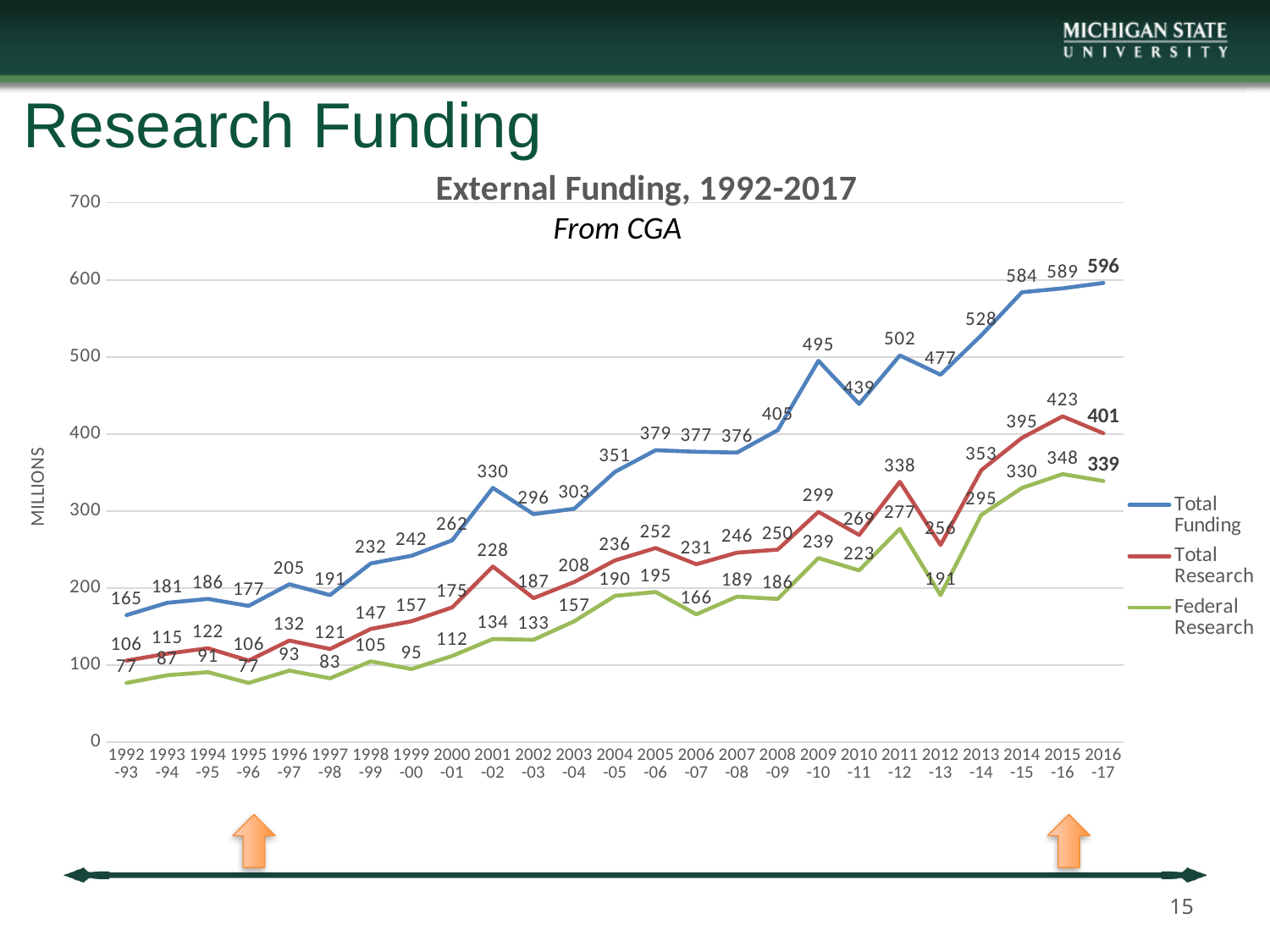
How many series does the legend list? 3 What is the difference between Total Funding and Total Research in 2009-10? 196 How many years are plotted on the x axis? 25 What is the Total Research value for 2011-12? 338 In which year is Total Research highest? 2015-16 What kind of chart is shown? line chart Is the Total Funding value for 2014-15 greater or less than 500? greater What is the title of the chart? External Funding, 1992-2017 Which is larger: Total Funding in 2012-13 or Total Funding in 2011-12? 2011-12 In which year is Federal Research lowest? 1992-93 and 1995-96 (both 77) What is the Federal Research value for 2001-02? 134 What is the Total Funding value for 2016-17? 596